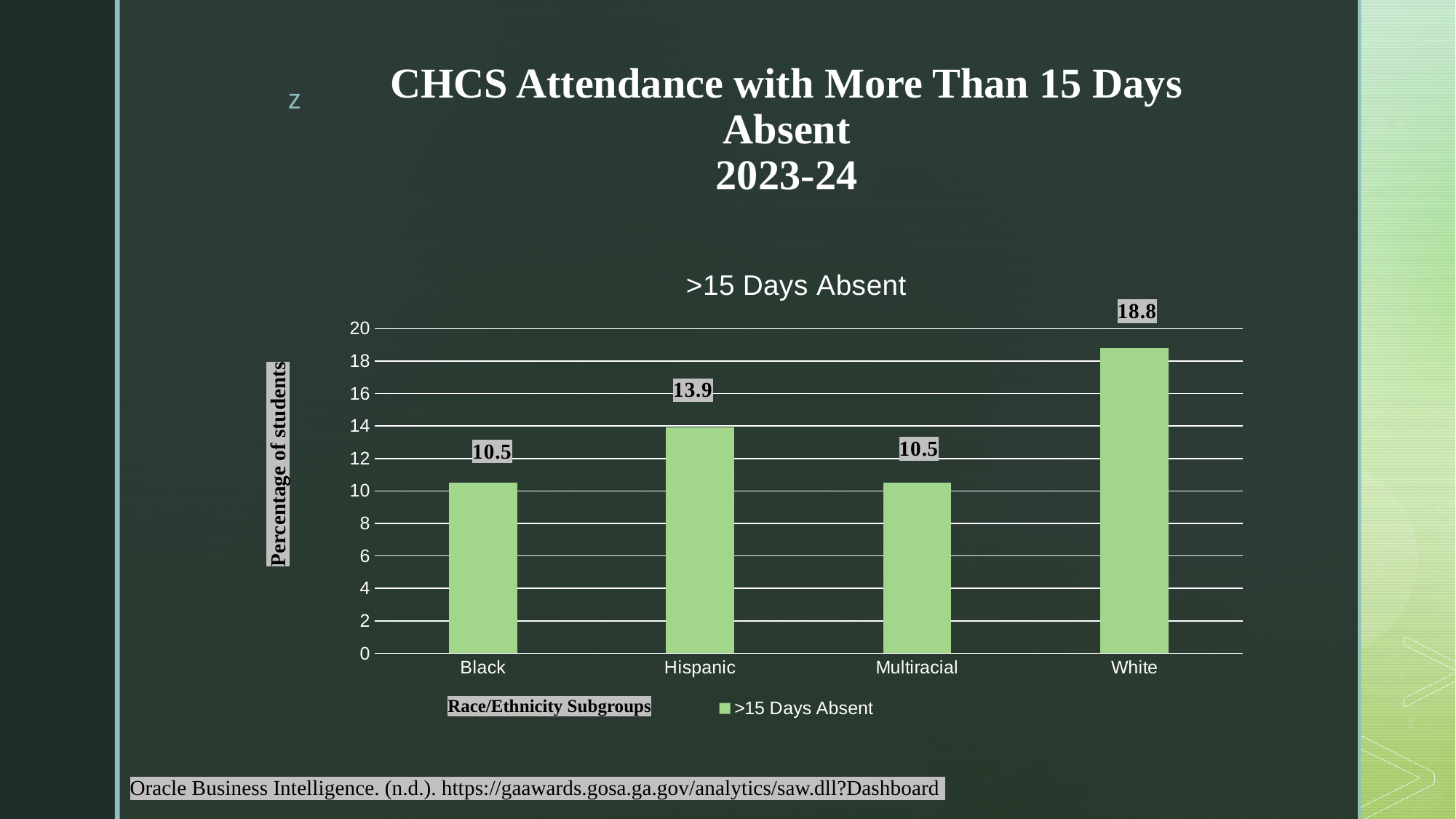
Which race/ethnicity subgroup has the highest percentage of students with more than 15 days absent? White What is the value for White in the >15 Days Absent chart? 18.8 What is the difference between the values for White and Hispanic? 4.9 Is the value for White greater or less than 16? greater How many series does the legend list? 1 How many race/ethnicity subgroups are shown on the x axis? 4 What is the label of the y axis? Percentage of students Which is larger, the value for Hispanic or the value for Black? Hispanic What is the value for Hispanic in the >15 Days Absent chart? 13.9 What is the difference between the values for Hispanic and Multiracial? 3.4 What is the value for Black in the >15 Days Absent chart? 10.5 What kind of chart is shown on the slide? Bar chart